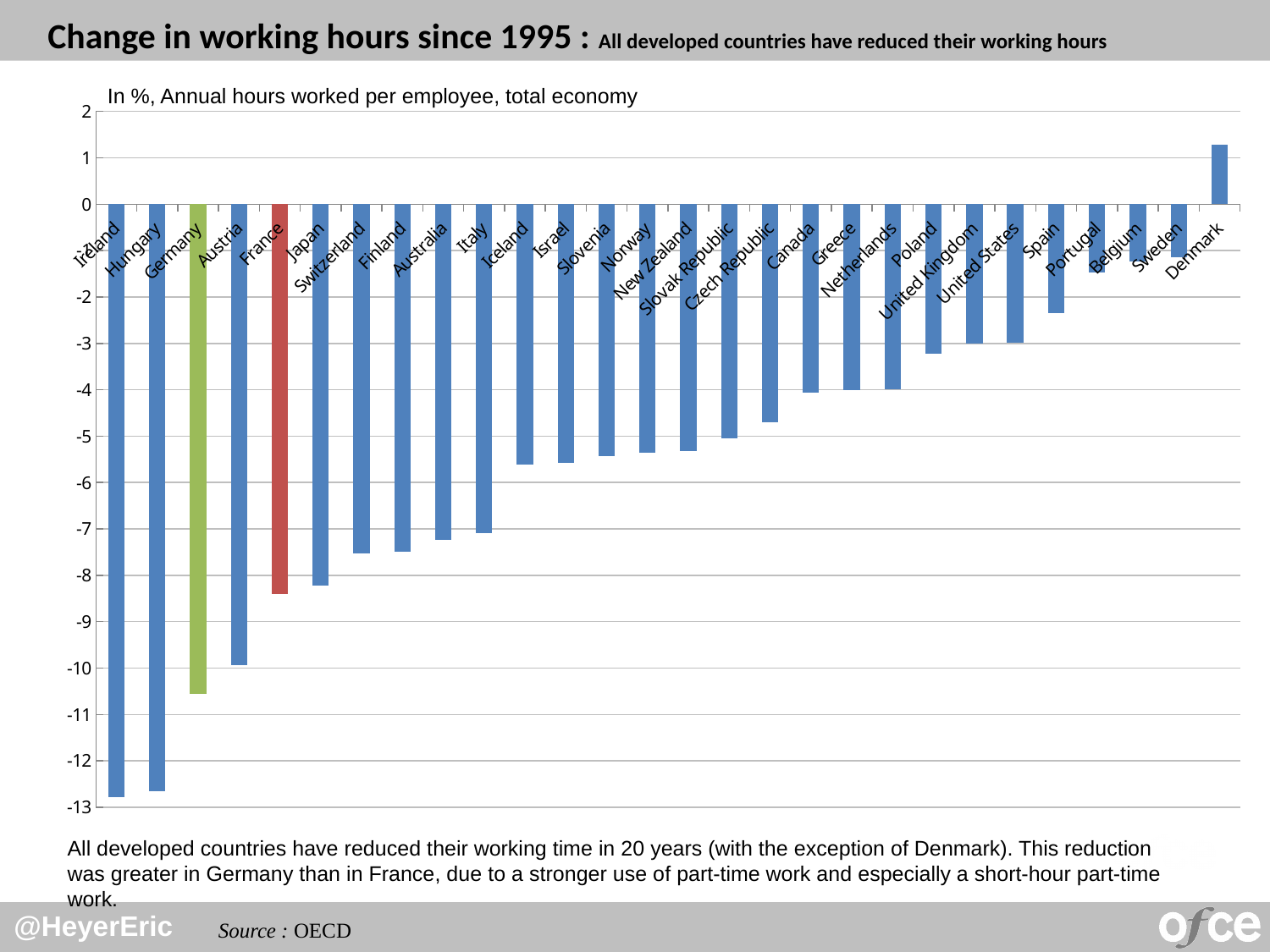
Do the values rise or fall moving from left to right along the x axis? rise Which country is the only one with a positive change in working hours? Denmark Is the value for France greater or less than -8? less What kind of chart is shown on the slide? bar chart Is the value for Canada greater or less than -5? greater Is the value for Germany greater or less than -10? less Which has the larger (less negative) value, Germany or France? France What is the source cited for the chart? OECD What colour is the bar for Germany? green How many countries are shown on the chart? 28